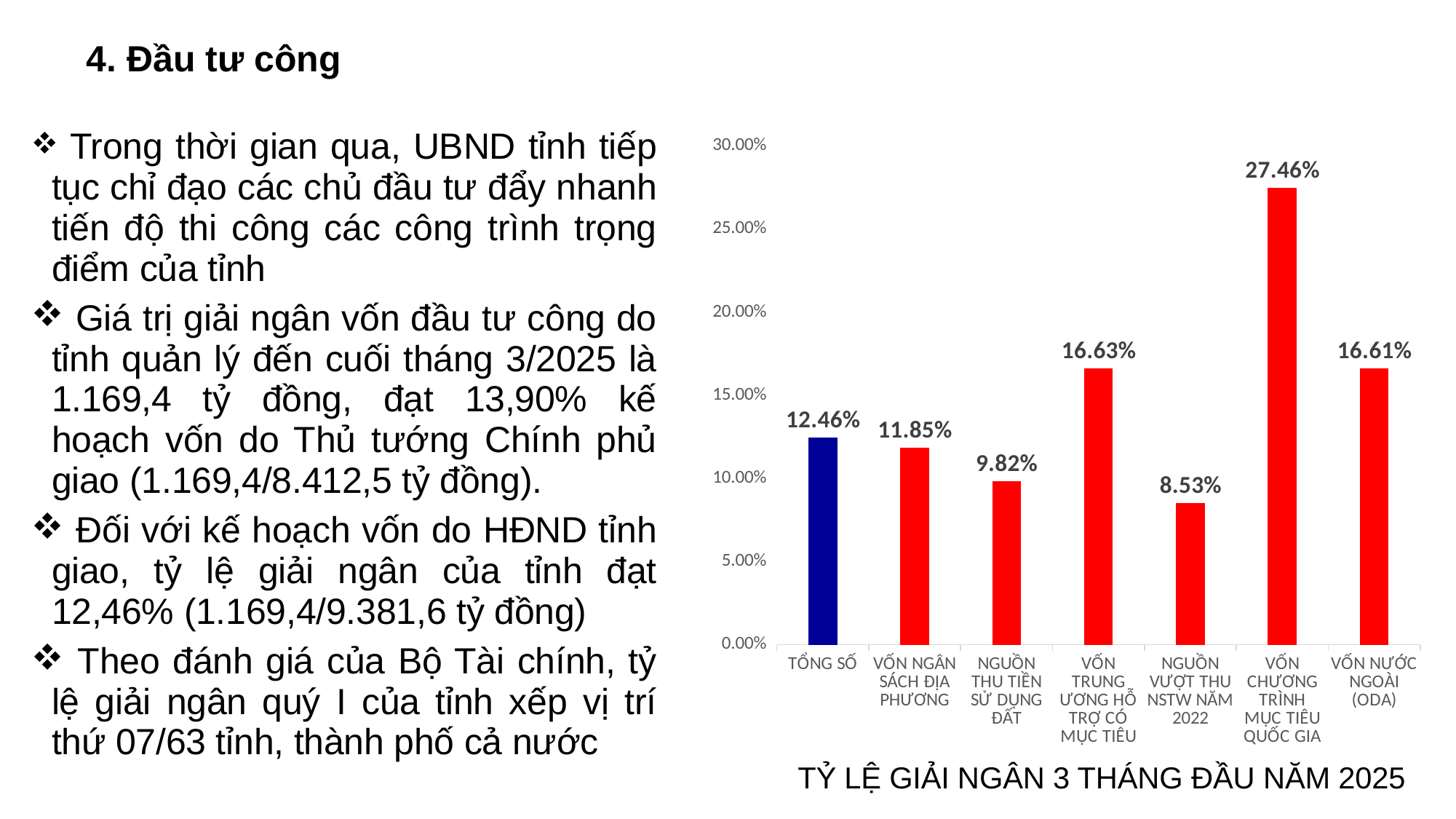
Which is larger, the value for VỐN TRUNG ƯƠNG HỖ TRỢ CÓ MỤC TIÊU or the value for NGUỒN THU TIỀN SỬ DỤNG ĐẤT? VỐN TRUNG ƯƠNG HỖ TRỢ CÓ MỤC TIÊU What is the value for TỔNG SỐ? 12.46% Which category has the lowest value? NGUỒN VƯỢT THU NSTW NĂM 2022 What is the difference between the values for VỐN CHƯƠNG TRÌNH MỤC TIÊU QUỐC GIA and NGUỒN VƯỢT THU NSTW NĂM 2022? 18.93% What kind of chart is shown on the slide? Bar chart What is the title of the chart? TỶ LỆ GIẢI NGÂN 3 THÁNG ĐẦU NĂM 2025 Which category has the highest value? VỐN CHƯƠNG TRÌNH MỤC TIÊU QUỐC GIA What is the value for NGUỒN THU TIỀN SỬ DỤNG ĐẤT? 9.82% What is the value for VỐN CHƯƠNG TRÌNH MỤC TIÊU QUỐC GIA? 27.46% How many categories are shown in the chart? 7 What is the value for VỐN NƯỚC NGOÀI (ODA)? 16.61% What is the difference between the values for TỔNG SỐ and VỐN NGÂN SÁCH ĐỊA PHƯƠNG? 0.61%